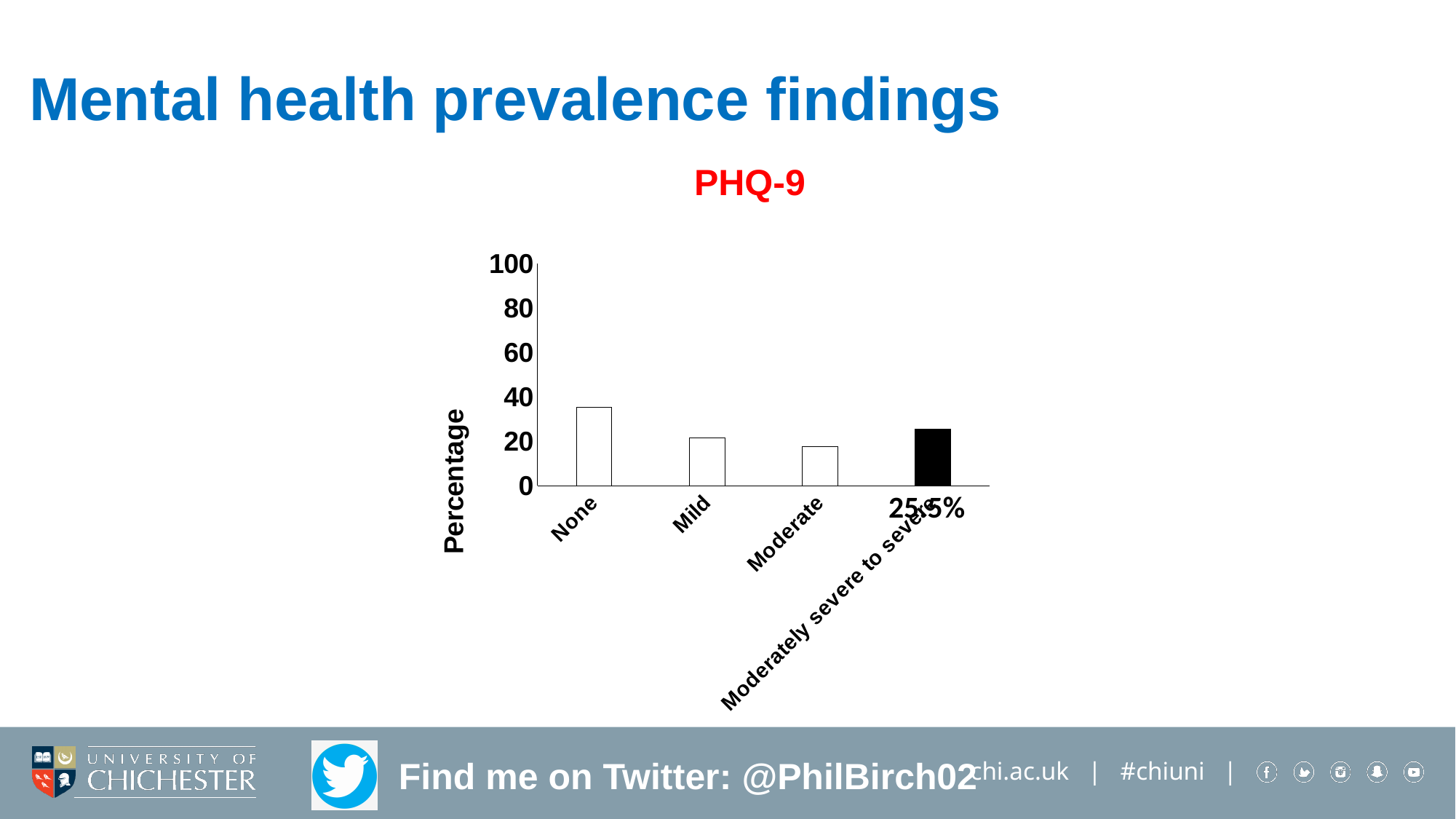
Which is larger, the value for Moderately severe to severe or the value for Moderate? Moderately severe to severe What is the title of the chart? PHQ-9 Which category has the highest percentage on the PHQ-9 chart? None What percentage is printed for the Moderately severe to severe category? 25.5% What kind of chart is shown on the slide? bar chart Which is larger, the value for None or the value for Mild? None What is the label on the vertical axis of the chart? Percentage Is the value for None greater or less than 40? less Is the value for None greater or less than 20? greater Is the value for Mild greater or less than 40? less How many categories are plotted on the PHQ-9 chart? 4